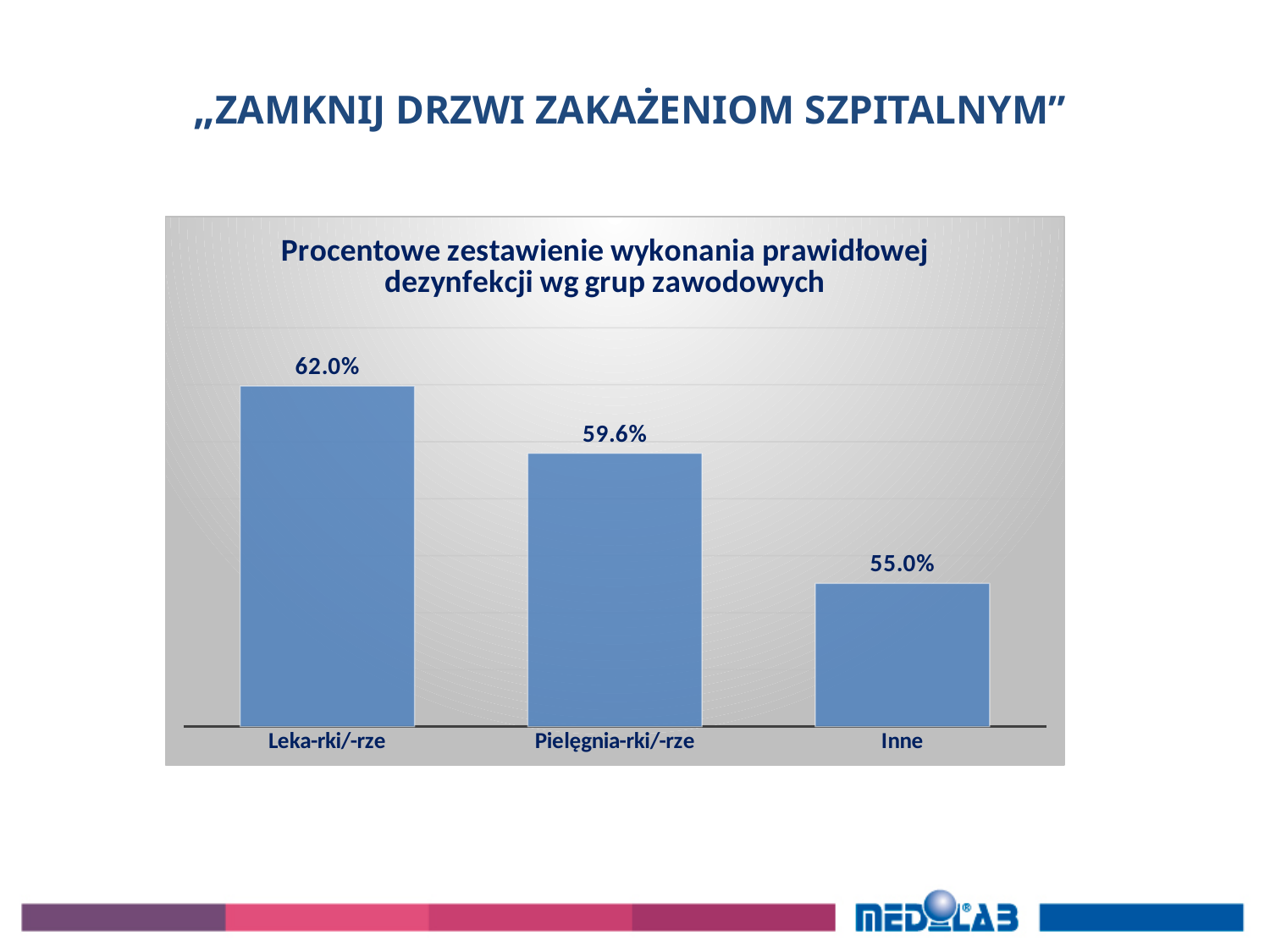
What is the value for Leka-rki/-rze? 62.0% Which category has the lowest value? Inne Do the values rise or fall from left to right across the categories? Fall What kind of chart is shown on the slide? Bar chart What is the difference between the values for Leka-rki/-rze and Pielęgnia-rki/-rze? 2.4% Which is larger, the value for Pielęgnia-rki/-rze or the value for Inne? Pielęgnia-rki/-rze What is the difference between the values for Pielęgnia-rki/-rze and Inne? 4.6% How many categories are shown in the chart? 3 Which category has the highest value? Leka-rki/-rze What is the difference between the values for Leka-rki/-rze and Inne? 7.0% What is the value for Pielęgnia-rki/-rze? 59.6% What is the value for Inne? 55.0%